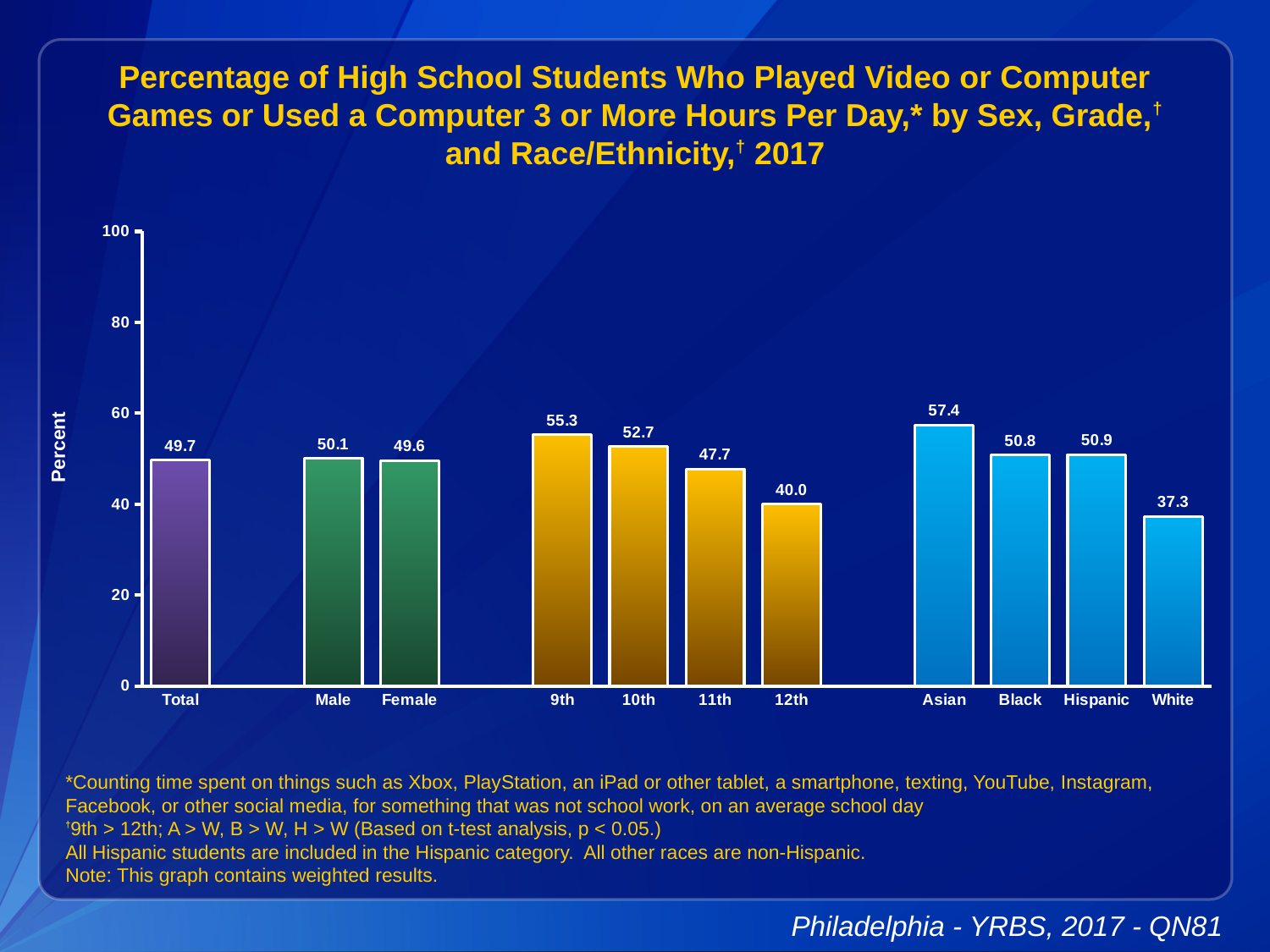
What is the value for Total? 49.7 Is the value for Asian greater or less than 60? less What is the value for 9th grade students? 55.3 Which category has the highest value? Asian Which category has the lowest value? White What is the difference between the values for 9th and 12th grade? 15.3 What is the value for White students? 37.3 Which is larger, the value for Male or the value for 11th grade? Male What kind of chart is this? bar chart Do the values rise or fall from 9th grade to 12th grade? fall How many categories are shown on the x axis? 11 What is the label on the y axis? Percent